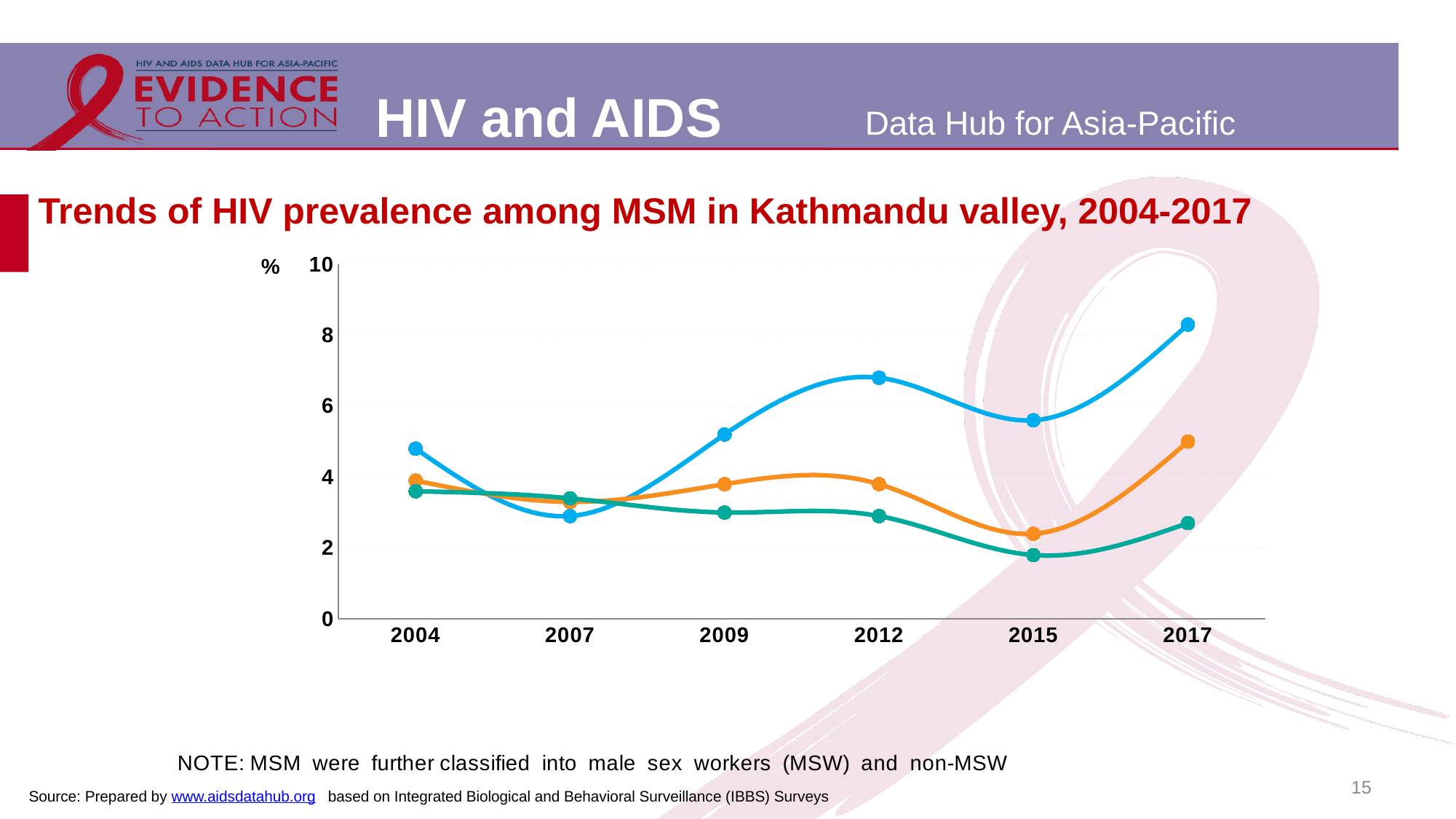
Does the blue line rise or fall between 2015 and 2017? rise What is the title of the chart? Trends of HIV prevalence among MSM in Kathmandu valley, 2004-2017 Is the value of the green line in 2015 greater or less than 2? less In which year does the green line reach its lowest value? 2015 Is the value of the orange line in 2017 greater or less than 4? greater What kind of chart is shown on the slide? line chart In 2017, which line has the larger value, the blue line or the green line? blue line How many years are marked on the x axis of the chart? 6 In which year does the blue line reach its highest value? 2017 Is the value of the blue line in 2017 greater or less than 6? greater How many lines are plotted on the chart? 3